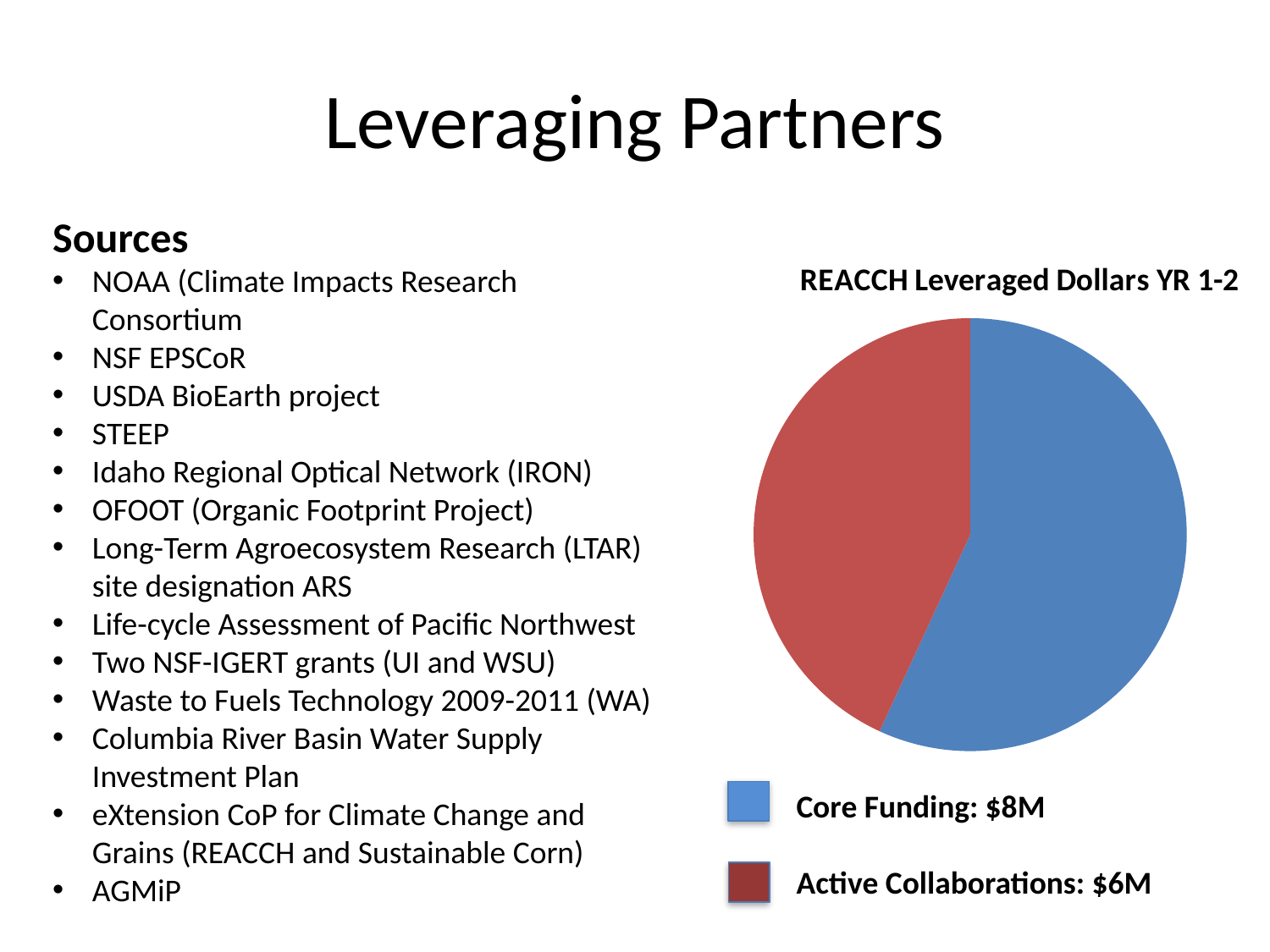
What colour is the Core Funding slice in the pie chart? blue Which is larger in the pie chart, Core Funding or Active Collaborations? Core Funding What is the total of Core Funding and Active Collaborations in the pie chart? $14M What is the value for Core Funding in the pie chart? $8M Which slice of the pie chart is the largest? Core Funding How many slices does the pie chart have? 2 What is the value for Active Collaborations in the pie chart? $6M What kind of chart is shown on the slide? pie chart Which slice of the pie chart is the smallest? Active Collaborations What is the difference between Core Funding and Active Collaborations in the pie chart? $2M What is the title of the pie chart? REACCH Leveraged Dollars YR 1-2